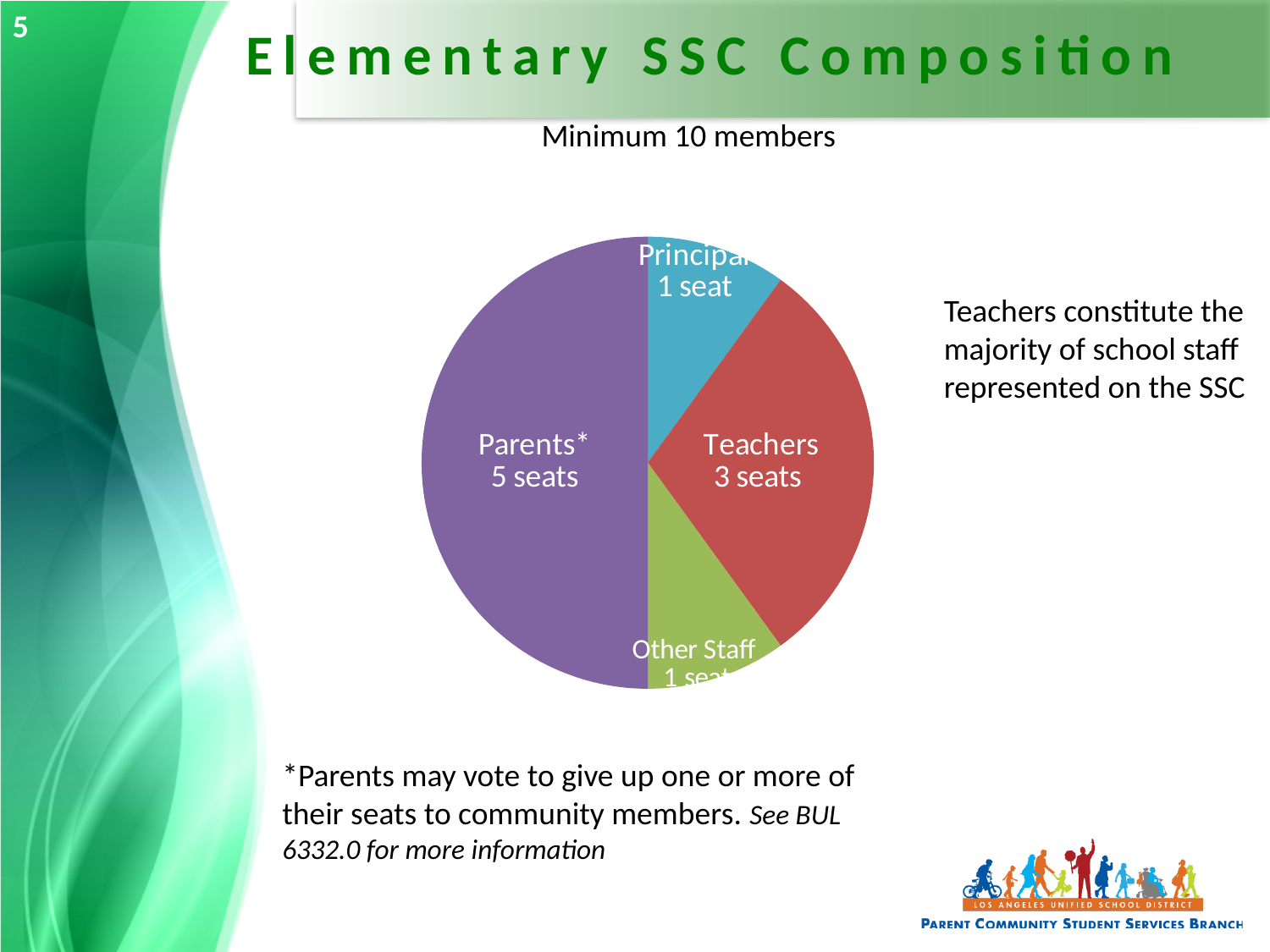
Which group has the largest slice of the pie? Parents How many slices does the pie chart have? 4 Which has more seats, Teachers or the Principal? Teachers How many seats do Parents have on the Elementary SSC? 5 seats What kind of chart is shown on the slide? pie chart How many seats does the Principal have? 1 seat How many more seats do Parents have than Teachers? 2 seats What share of the total seats do Parents hold? 50% What is the title of the slide containing the chart? Elementary SSC Composition How many seats do Teachers have on the Elementary SSC? 3 seats What is the total number of seats shown in the pie chart? 10 seats How many seats does Other Staff have? 1 seat